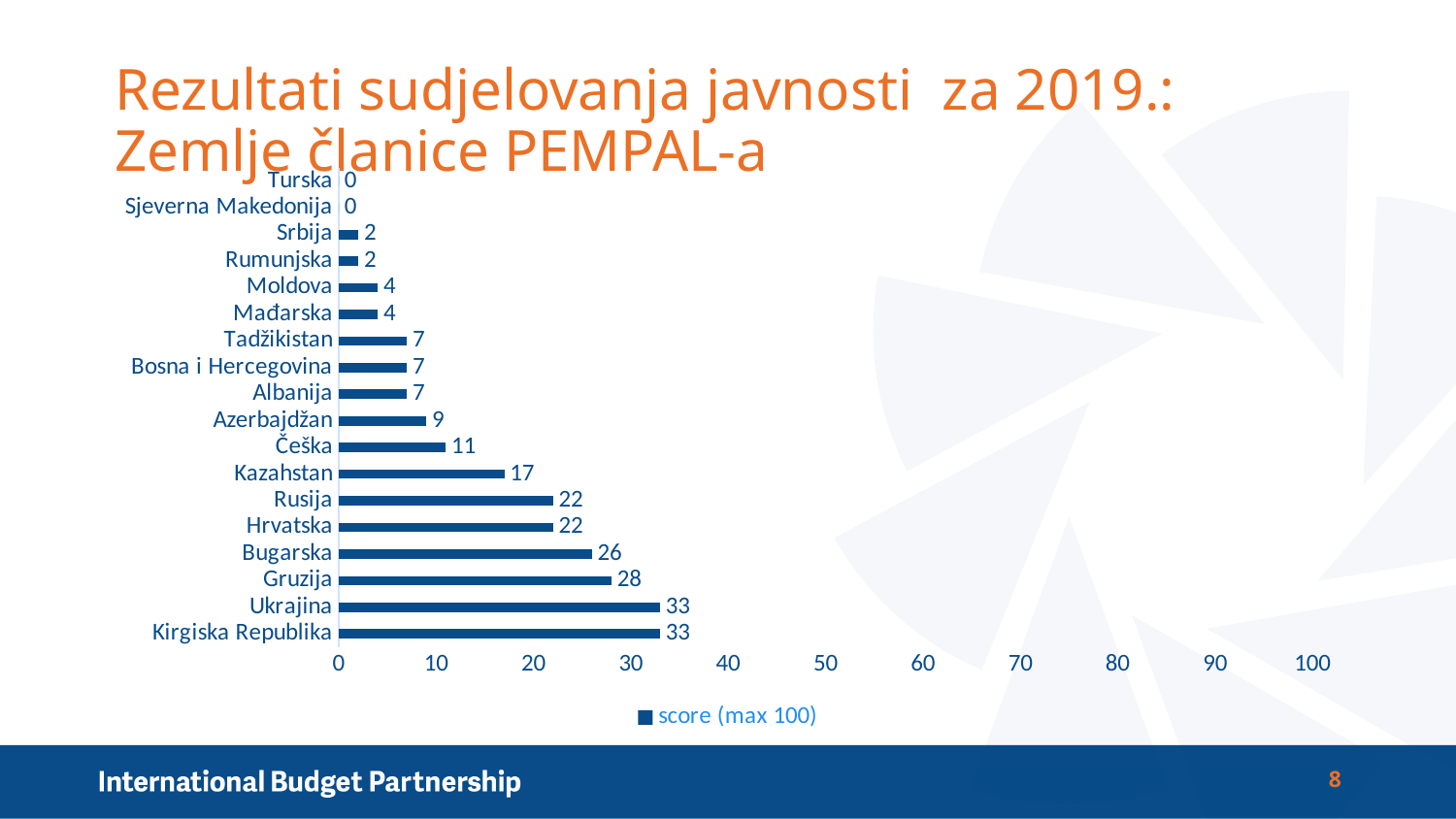
Which two countries share the highest score of 33? Ukrajina and Kirgiska Republika What is the difference between the scores of Bugarska and Kazahstan? 9 Which countries have a score of 0? Turska and Sjeverna Makedonija What is the legend entry for the series in the chart? score (max 100) How many countries are shown in the chart? 18 What is the score for Češka? 11 Which has a higher score, Gruzija or Rusija? Gruzija How many series does the legend list? 1 What is the score for Azerbajdžan? 9 What kind of chart is shown on the slide? Bar chart What is the score for Gruzija? 28 What is the score for Kazahstan? 17